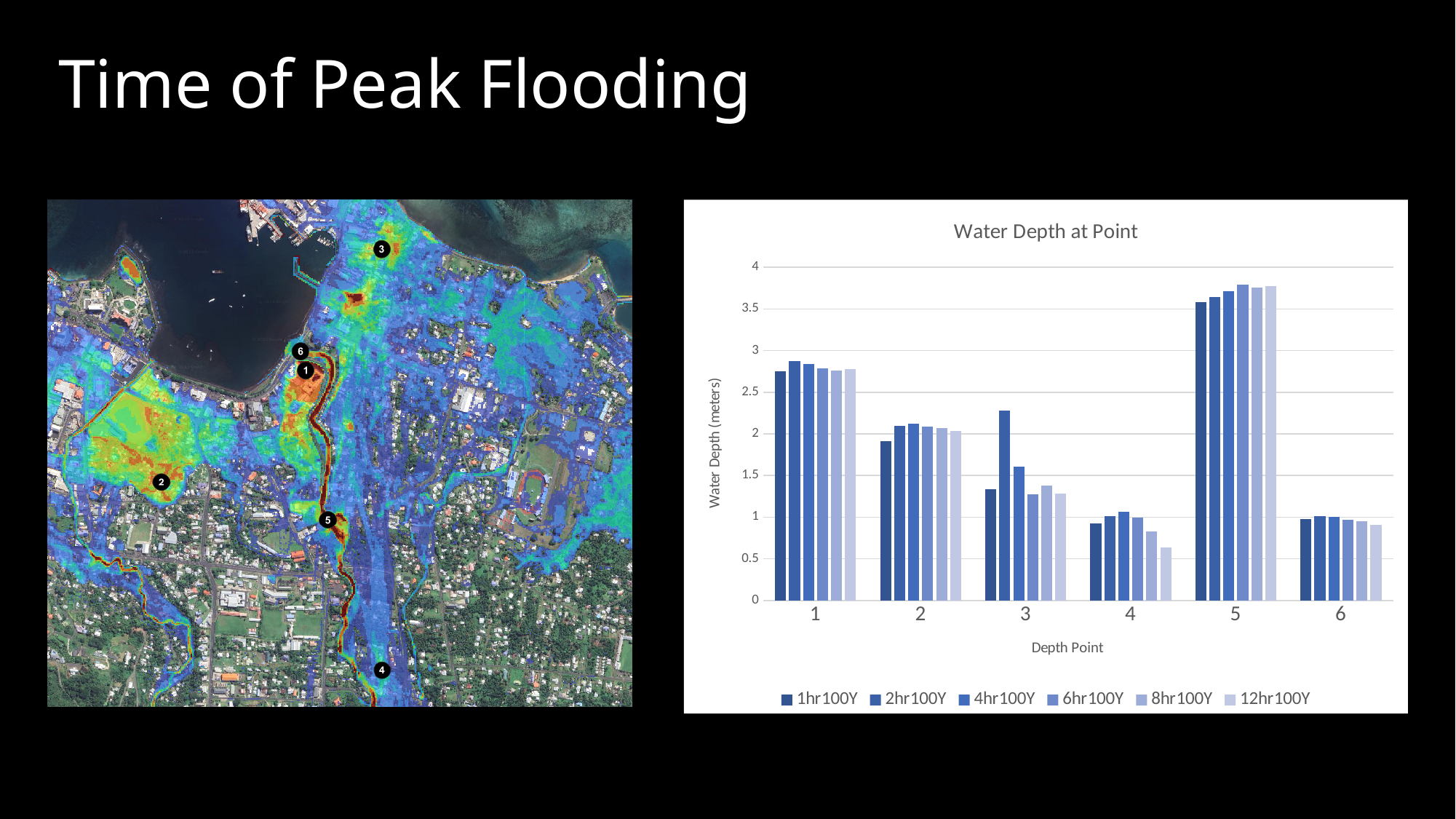
How many depth points are shown on the x axis of the chart? 6 Which depth point has the lowest water depth value in the chart? 4 Which depth point has the larger water depth for the 6hr100Y series: depth point 5 or depth point 6? 5 Is the water depth for the 1hr100Y series at depth point 5 greater or less than 3? greater At depth point 3, which series has the larger water depth: 2hr100Y or 4hr100Y? 2hr100Y How many series does the chart's legend list? 6 What is the label of the vertical axis of the chart? Water Depth (meters) Is the water depth for the 12hr100Y series at depth point 4 greater or less than 1? less Is the water depth for the 2hr100Y series at depth point 3 greater or less than 2? greater What is the title of the chart on the slide? Water Depth at Point What type of chart is shown on the slide? Bar chart Which depth point has the highest water depth values in the chart? 5